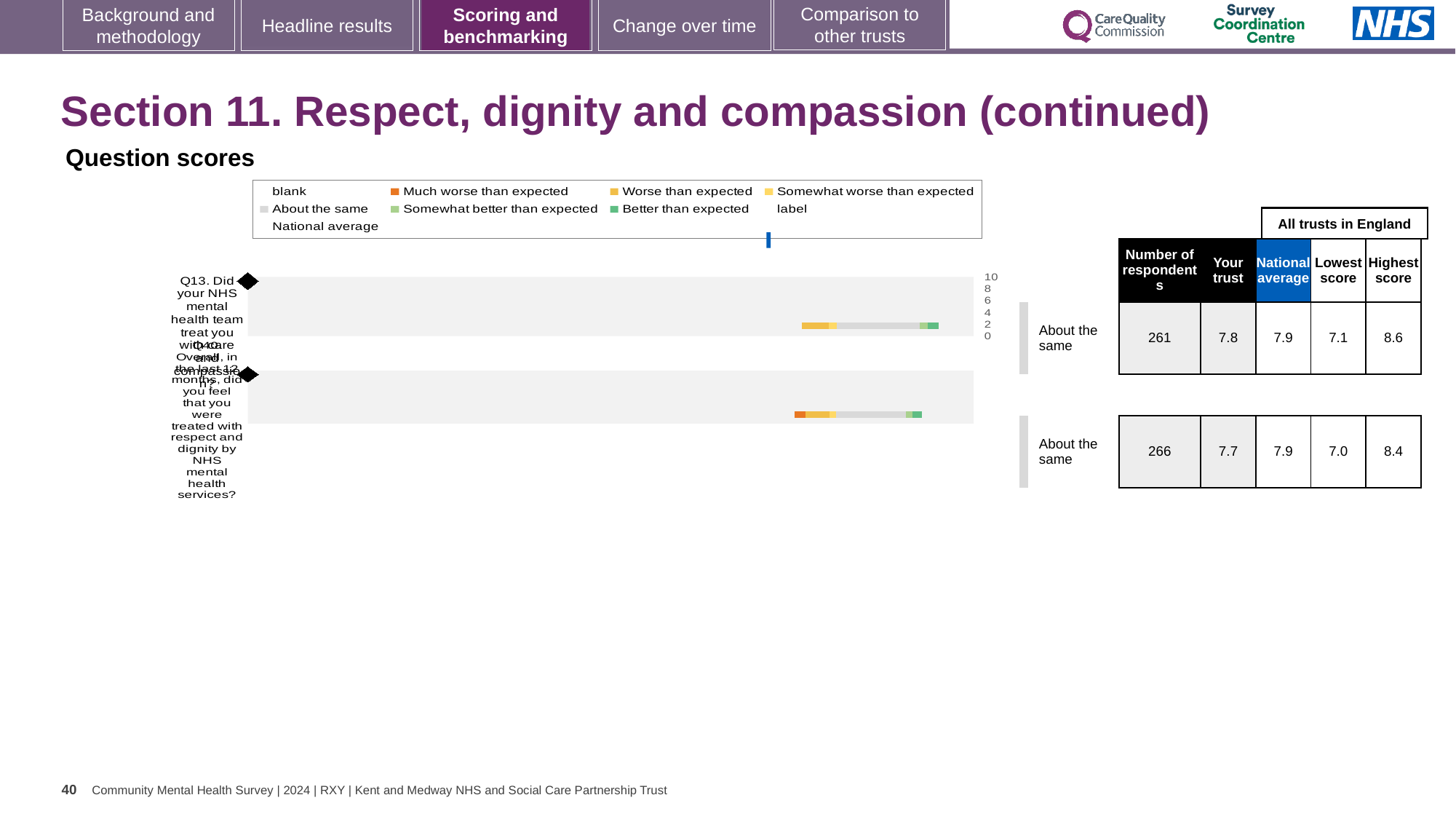
Which question has the higher 'Your trust' score, Q13 or Q14? Q13 What is the 'Your trust' score for Q13 (Did your NHS mental health team treat you with care and compassion?)? 7.8 What kind of chart is used to show the question scores on this slide? bar chart How many questions (categories) are plotted in the question scores chart? 2 What benchmark category is shown next to both Q13 and Q14 in the chart? About the same What is the highest score among all trusts in England for Q13? 8.6 What is the 'Your trust' score for Q14 (treated with respect and dignity by NHS mental health services)? 7.7 What is the national average score shown for Q13? 7.9 What is the lowest score among all trusts in England for Q14? 7.0 How many more respondents answered Q14 than Q13? 5 How many respondents are listed for Q14? 266 What is the difference between the highest and lowest trust scores in England for Q13? 1.5